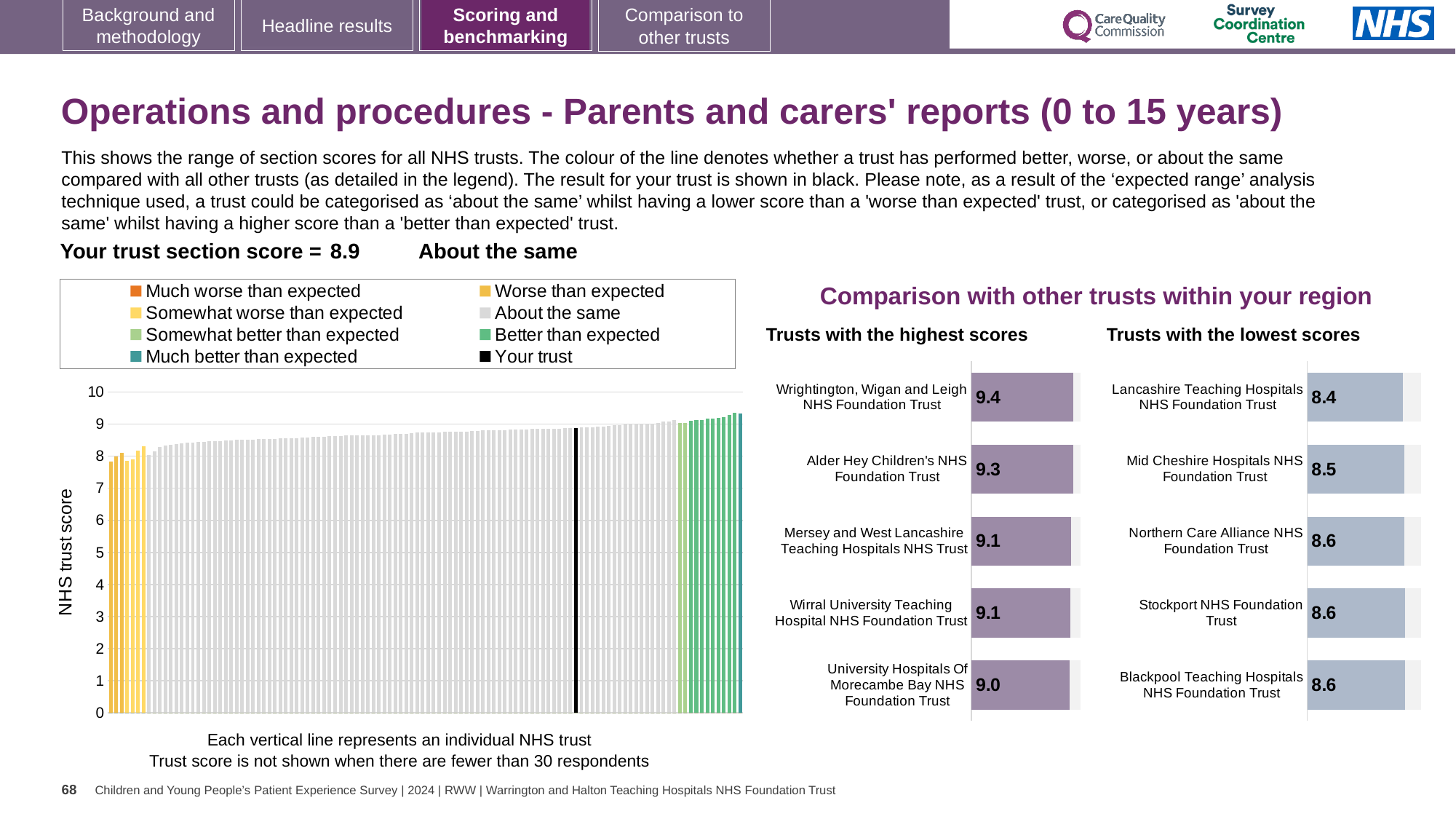
In the NHS trust score chart on the left, do the bar heights rise or fall from left to right? Rise In the 'Trusts with the lowest scores' chart, what is the score for Mid Cheshire Hospitals NHS Foundation Trust? 8.5 In the 'Trusts with the lowest scores' chart, which trust has the lowest score? Lancashire Teaching Hospitals NHS Foundation Trust What kind of chart is the NHS trust score chart on the left of the slide? Bar chart In the 'Trusts with the lowest scores' chart, what is the score for Lancashire Teaching Hospitals NHS Foundation Trust? 8.4 In the 'Trusts with the highest scores' chart, what is the score for Alder Hey Children's NHS Foundation Trust? 9.3 How many trusts are shown in the 'Trusts with the lowest scores' chart? 5 In the 'Trusts with the highest scores' chart, what is the score for Wrightington, Wigan and Leigh NHS Foundation Trust? 9.4 What is the difference between the score for Wrightington, Wigan and Leigh NHS Foundation Trust in the highest scores chart and the score for Lancashire Teaching Hospitals NHS Foundation Trust in the lowest scores chart? 1.0 How many entries does the legend of the NHS trust score chart on the left list? 8 In the 'Trusts with the highest scores' chart, which trust has the highest score? Wrightington, Wigan and Leigh NHS Foundation Trust In the 'Trusts with the highest scores' chart, which has the larger score: Alder Hey Children's NHS Foundation Trust or University Hospitals Of Morecambe Bay NHS Foundation Trust? Alder Hey Children's NHS Foundation Trust